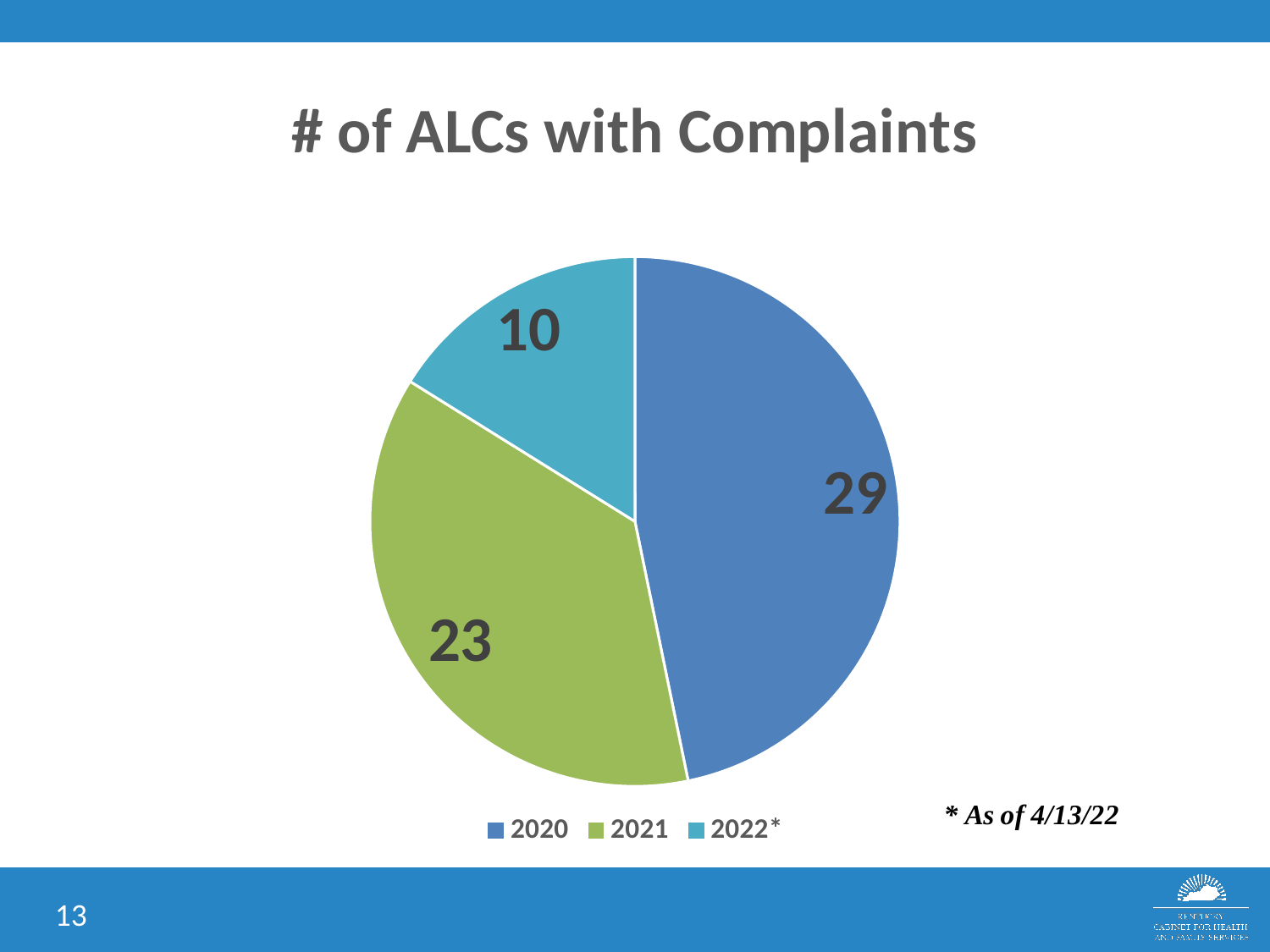
What is the title of the chart? # of ALCs with Complaints What is the value for 2022* in the pie chart? 10 Which year has the smallest slice in the pie chart? 2022* What is the value for 2021 in the pie chart? 23 What is the value for 2020 in the pie chart? 29 How many slices does the pie chart have? 3 What kind of chart is shown on the slide? Pie chart What is the difference between the values for 2020 and 2021? 6 How many entries does the legend list? 3 What is the difference between the values for 2021 and 2022*? 13 Which is larger, the value for 2021 or the value for 2022*? 2021 Which year has the largest slice in the pie chart? 2020